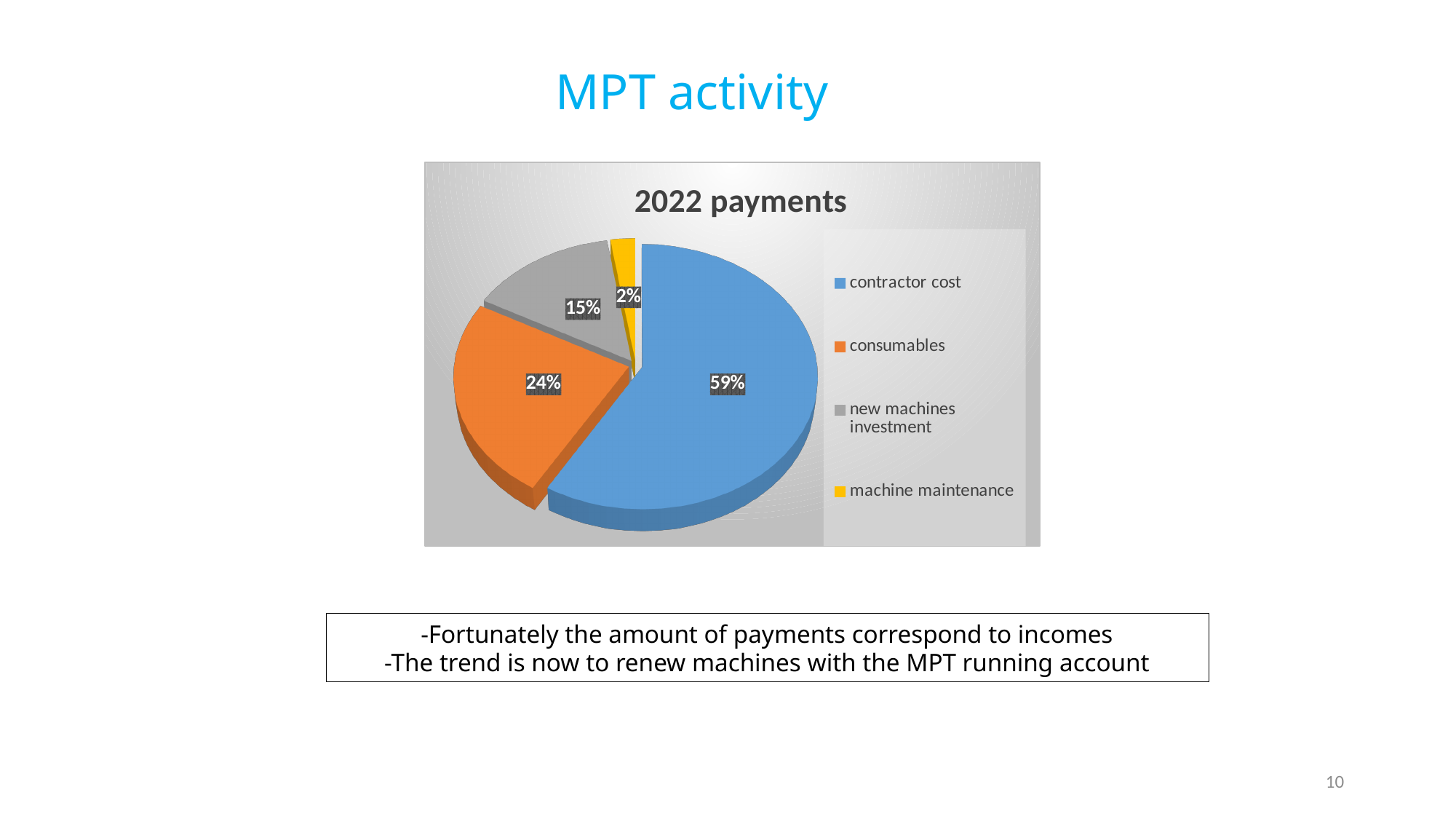
What is the difference in percentage points between contractor cost and consumables? 35 Which is larger, the share for consumables or the share for new machines investment? consumables Which category has the largest share of 2022 payments? contractor cost What share of 2022 payments is consumables? 24% What share of 2022 payments is contractor cost? 59% What is the difference in percentage points between new machines investment and machine maintenance? 13 How many categories does the pie chart show? 4 What is the title of the chart? 2022 payments What kind of chart is shown on the slide? pie chart Which category has the smallest share of 2022 payments? machine maintenance What share of 2022 payments is new machines investment? 15%